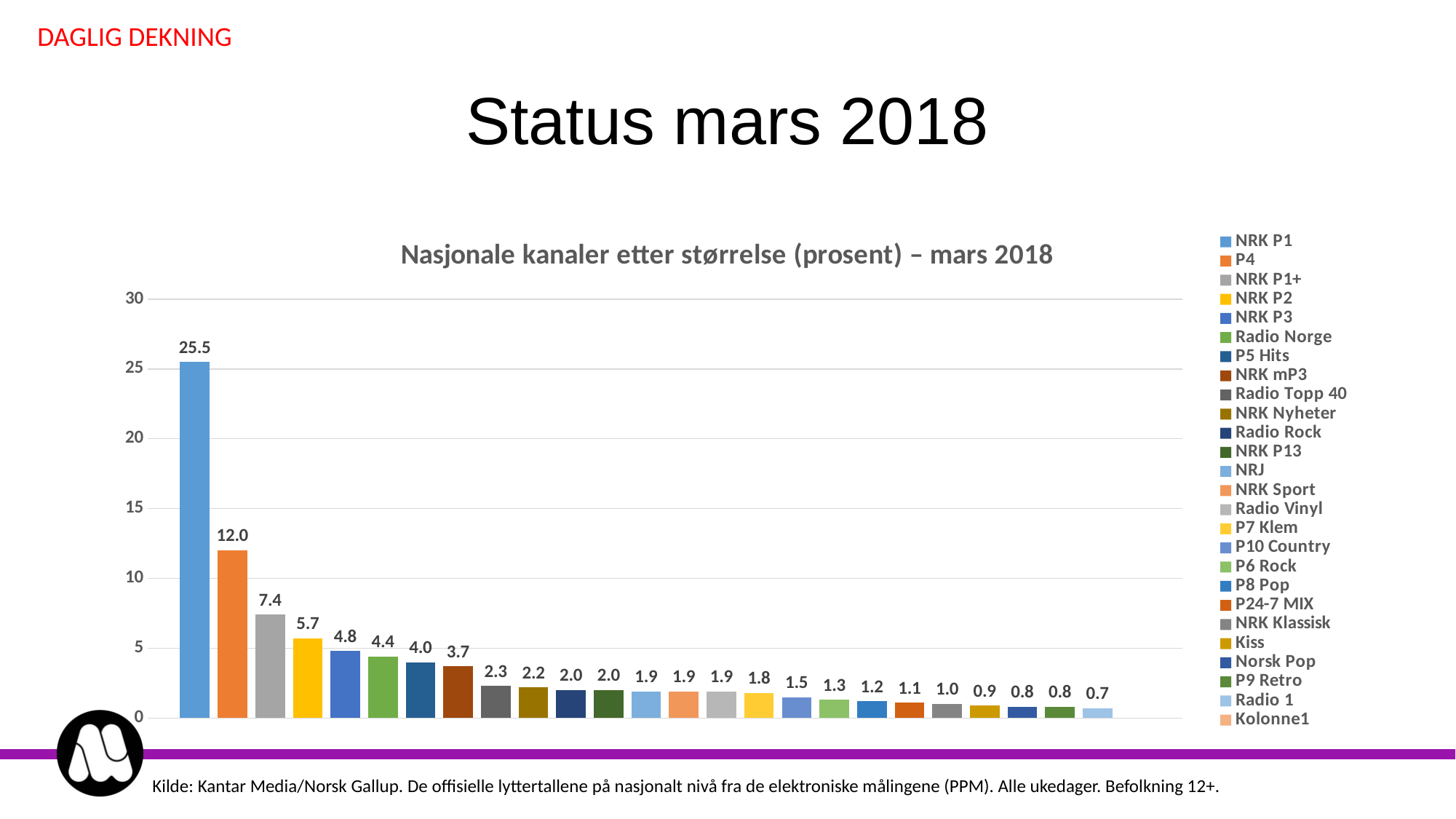
Which channel has the highest value? NRK P1 Which is larger, the value for NRK P1+ or the value for NRK P3? NRK P1+ What is the value for Radio Norge? 4.4 What is the title of the chart? Nasjonale kanaler etter størrelse (prosent) – mars 2018 What kind of chart is shown on the slide? bar chart Is the value for NRK P1 greater or less than 25? greater Which channel has the lowest value? Radio 1 What is the value for P4? 12.0 What is the difference between the values for NRK P1 and P4? 13.5 What is the value for NRK P2? 5.7 What is the value for NRK P1? 25.5 How many bars are plotted in the chart? 25